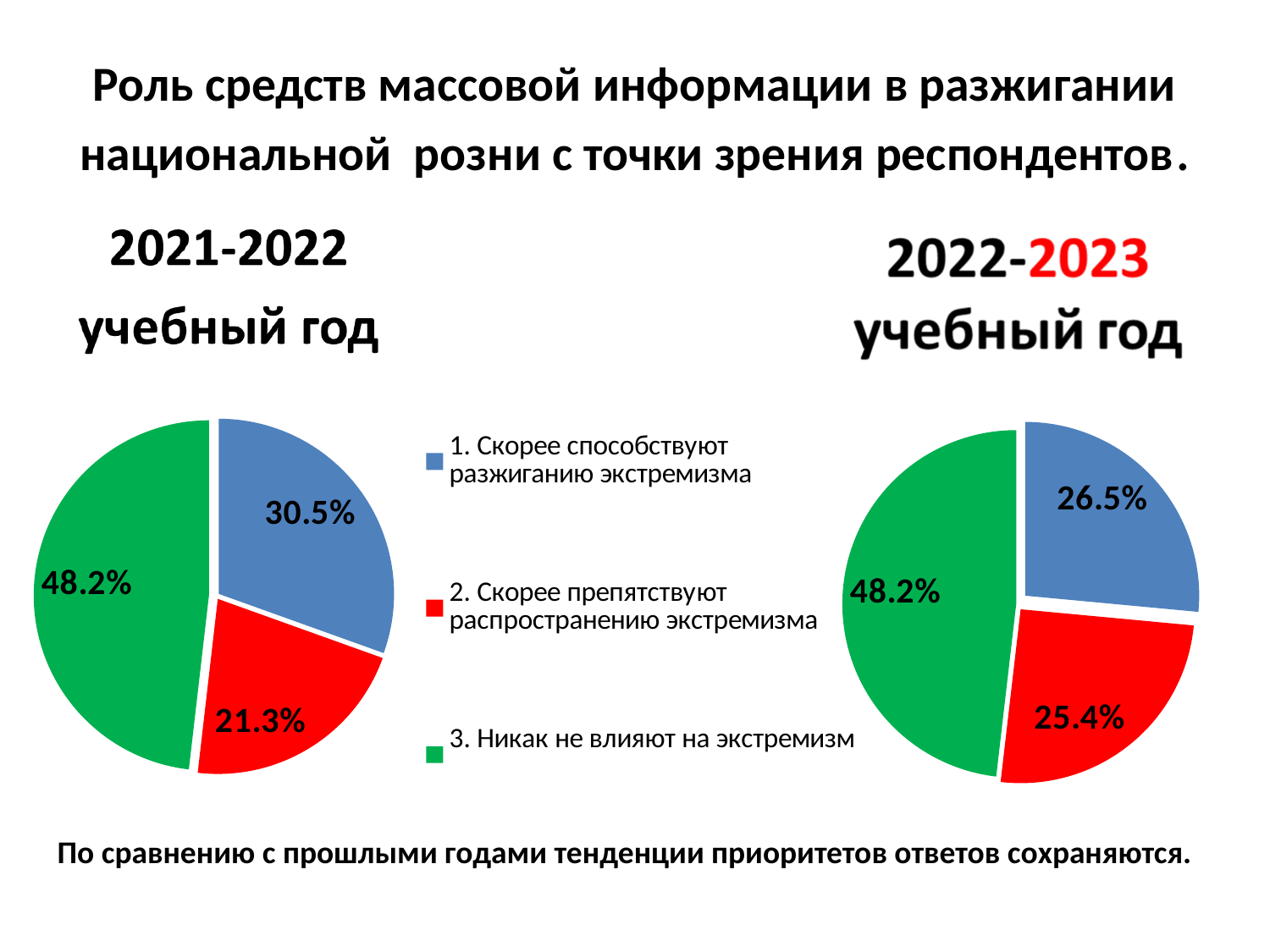
In the 2021-2022 учебный год pie chart, what share is labelled for the blue slice (1. Скорее способствуют разжиганию экстремизма)? 30.5% In the 2022-2023 учебный год pie chart, what is the difference between the blue slice (26.5%) and the red slice (25.4%)? 1.1% In the 2022-2023 учебный год pie chart, what share is labelled for the green slice (3. Никак не влияют на экстремизм)? 48.2% In the 2021-2022 учебный год pie chart, what share is labelled for the red slice (2. Скорее препятствуют распространению экстремизма)? 21.3% In the 2022-2023 учебный год pie chart, which category has the largest slice? 3. Никак не влияют на экстремизм How many slices does each pie chart on the slide have? 3 In the 2021-2022 учебный год pie chart, which category has the largest slice? 3. Никак не влияют на экстремизм What kind of chart is used for the 2021-2022 учебный год data? pie chart What is the difference between the blue slice (1. Скорее способствуют разжиганию экстремизма) in the 2021-2022 pie chart and the same slice in the 2022-2023 pie chart? 4.0% How many entries does the legend between the two pie charts list? 3 In the 2021-2022 учебный год pie chart, which category has the smallest slice? 2. Скорее препятствуют распространению экстремизма In the 2022-2023 учебный год pie chart, what share is labelled for the red slice (2. Скорее препятствуют распространению экстремизма)? 25.4%